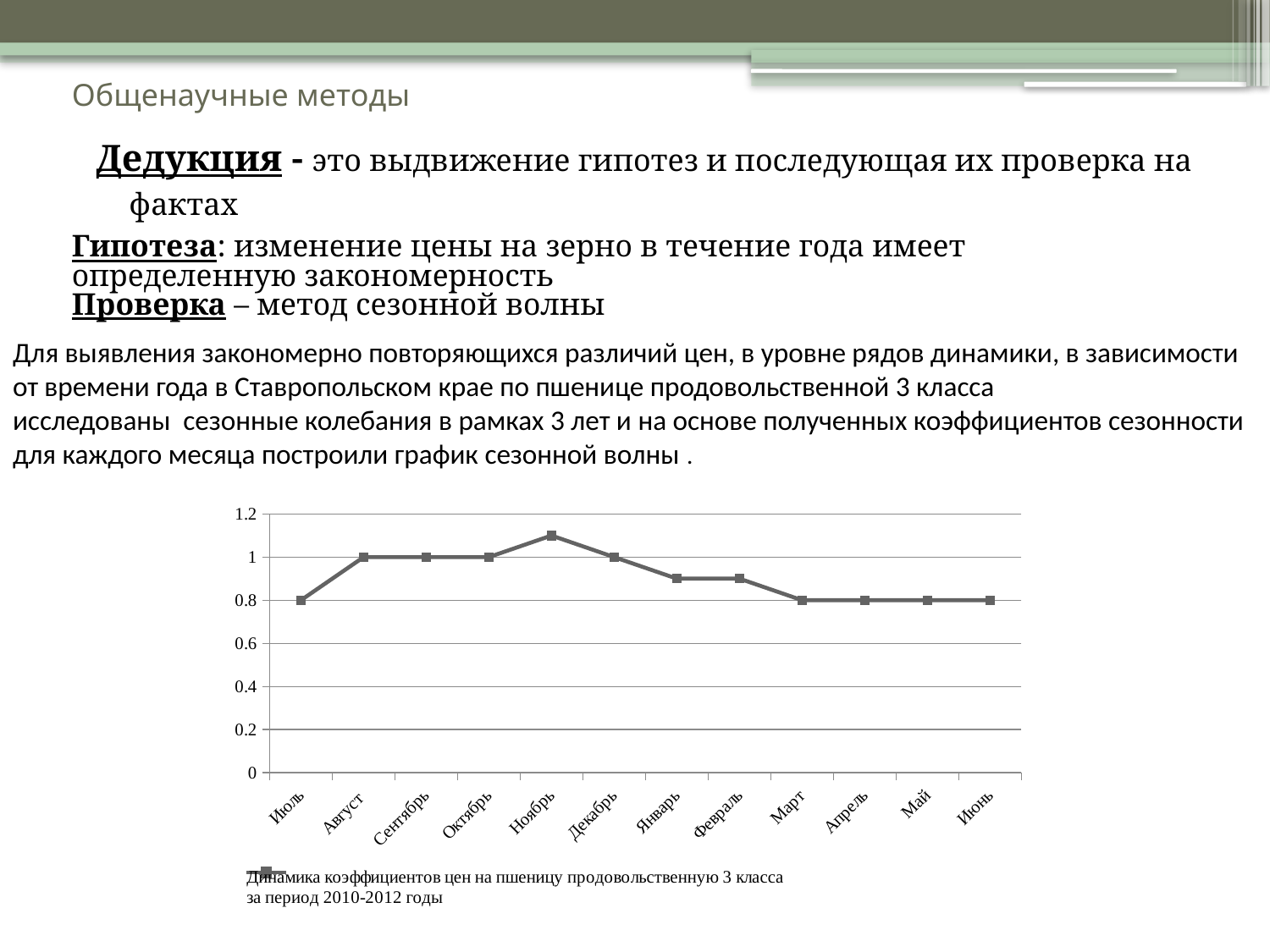
Which month has the highest value on the chart? Ноябрь What is the value for Август on the chart? 1 Which is larger, the value for Октябрь or the value for Март? Октябрь What is the value for Июнь on the chart? 0.8 How many months are plotted along the x axis of the chart? 12 What is the value for Декабрь on the chart? 1 Is the value for Январь greater or less than 1? less Is the value for Ноябрь greater or less than 1? greater Do the values rise or fall from Ноябрь to Март? fall What type of chart is shown on the slide? Line chart What is the value for Июль on the chart? 0.8 How many series does the chart's legend list? 1